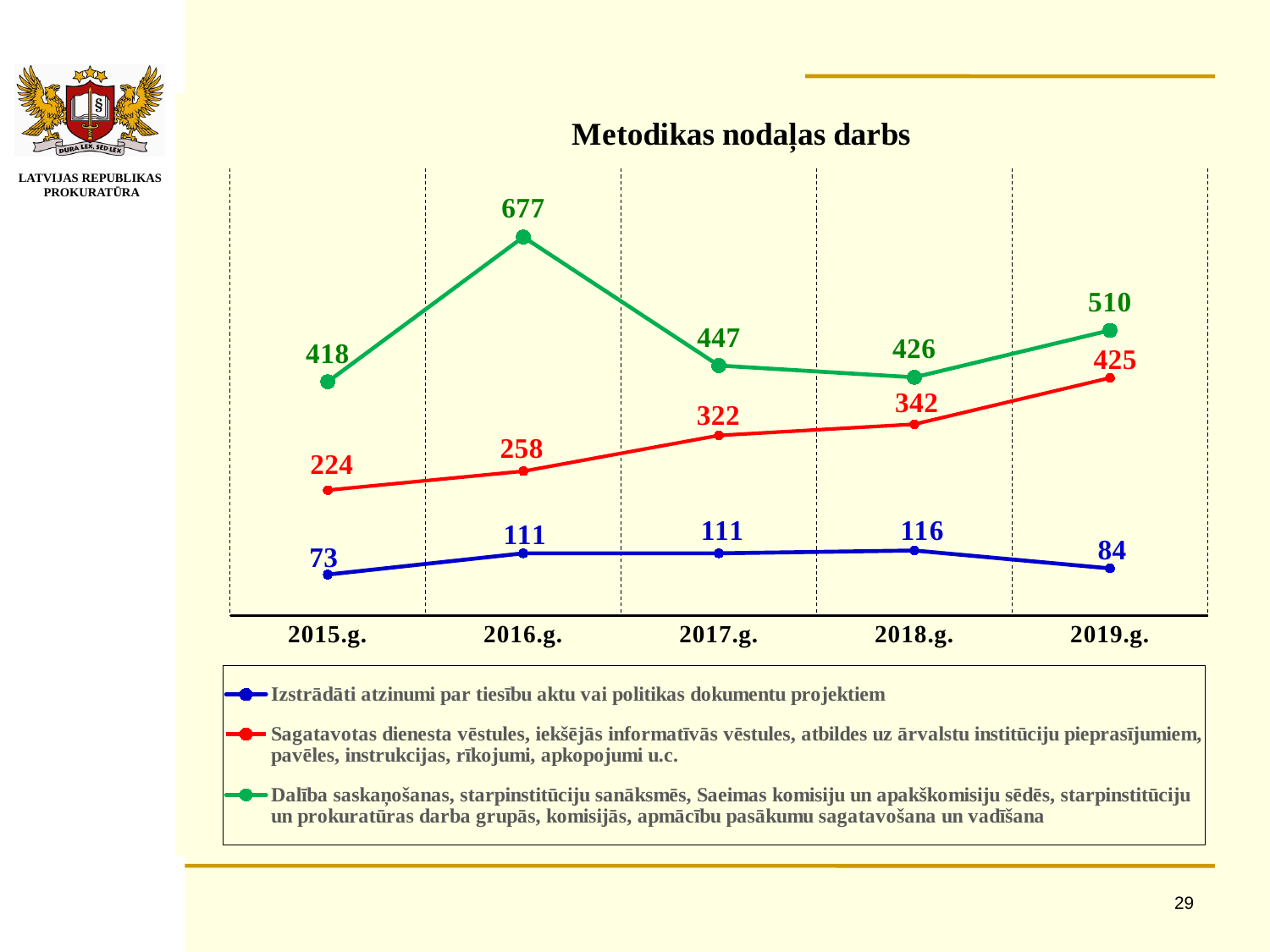
Does the red series rise or fall from 2015.g. to 2019.g.? rise What is the value of the green series (Dalība saskaņošanas, starpinstitūciju sanāksmēs...) in 2016.g.? 677 How many series does the legend list? 3 Which is larger in 2019.g.: the green series value or the red series value? the green series (510) In which year is the blue series at its lowest value? 2015.g. What is the value of the red series (Sagatavotas dienesta vēstules...) in 2018.g.? 342 What is the chart's title? Metodikas nodaļas darbs What is the difference between the green series value in 2016.g. and its value in 2017.g.? 230 In which year does the green series reach its highest value? 2016.g. How many years are shown on the x axis? 5 What is the value of the blue series (Izstrādāti atzinumi par tiesību aktu vai politikas dokumentu projektiem) in 2015.g.? 73 What type of chart is shown on the slide? line chart